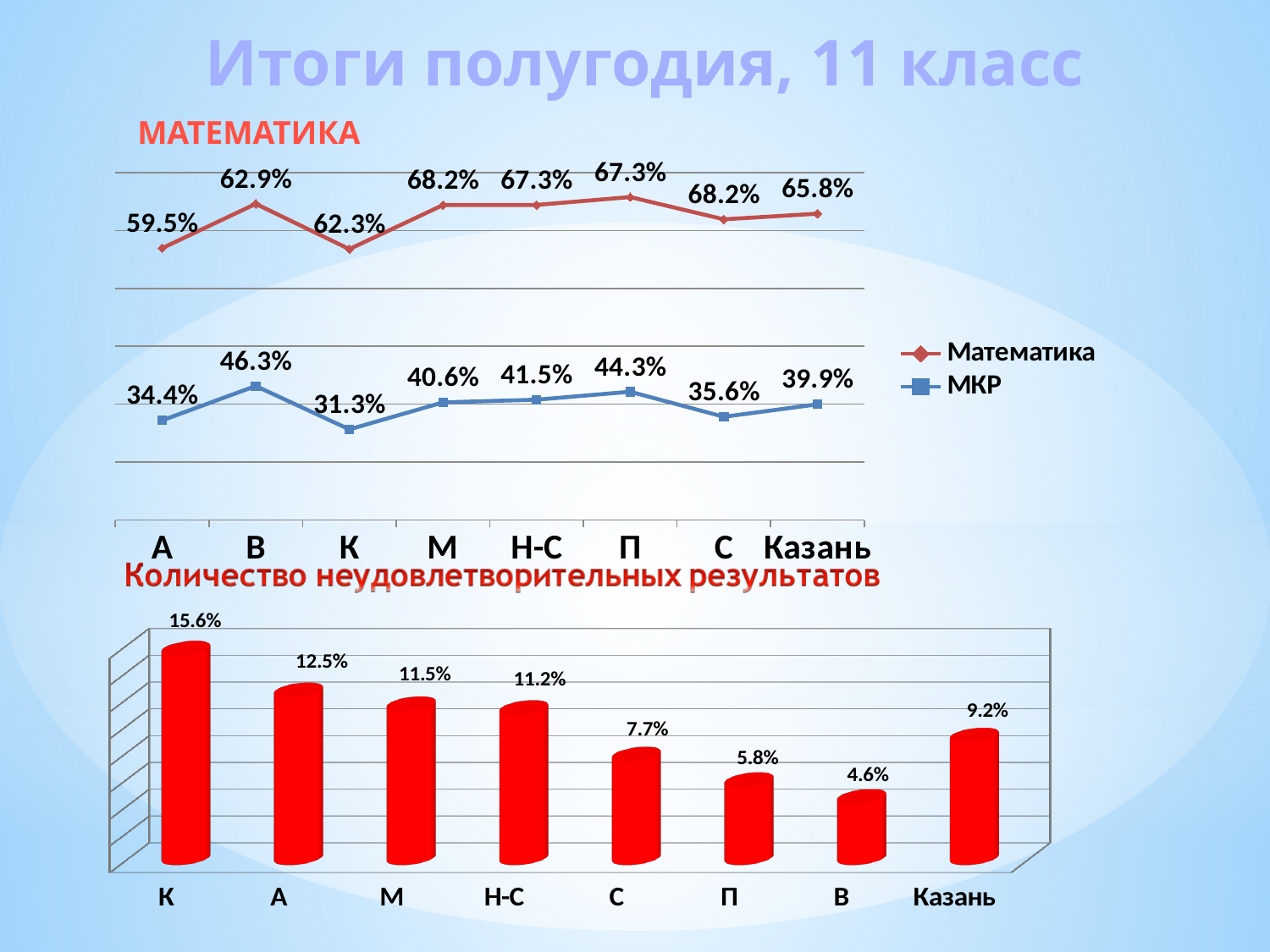
What kind of chart is the Количество неудовлетворительных результатов chart? bar chart In the МАТЕМАТИКА line chart, which category has the highest МКР value? В In the Количество неудовлетворительных результатов chart, which category has the lowest value? В In the Количество неудовлетворительных результатов chart, what is the value for Н-С? 11.2% In the МАТЕМАТИКА line chart, how many series does the legend list? 2 In the МАТЕМАТИКА line chart, what is the МКР value for category П? 44.3% In the Количество неудовлетворительных результатов chart, which category has the highest value? К In the МАТЕМАТИКА line chart, what is the difference between the Математика and МКР values for Казань? 25.9% In the МАТЕМАТИКА line chart, what is the Математика value for category В? 62.9% In the МАТЕМАТИКА line chart, is the МКР value for К larger or smaller than the МКР value for М? smaller In the Количество неудовлетворительных результатов chart, what is the difference between the values for К and А? 3.1% In the МАТЕМАТИКА line chart, which category has the lowest Математика value? А